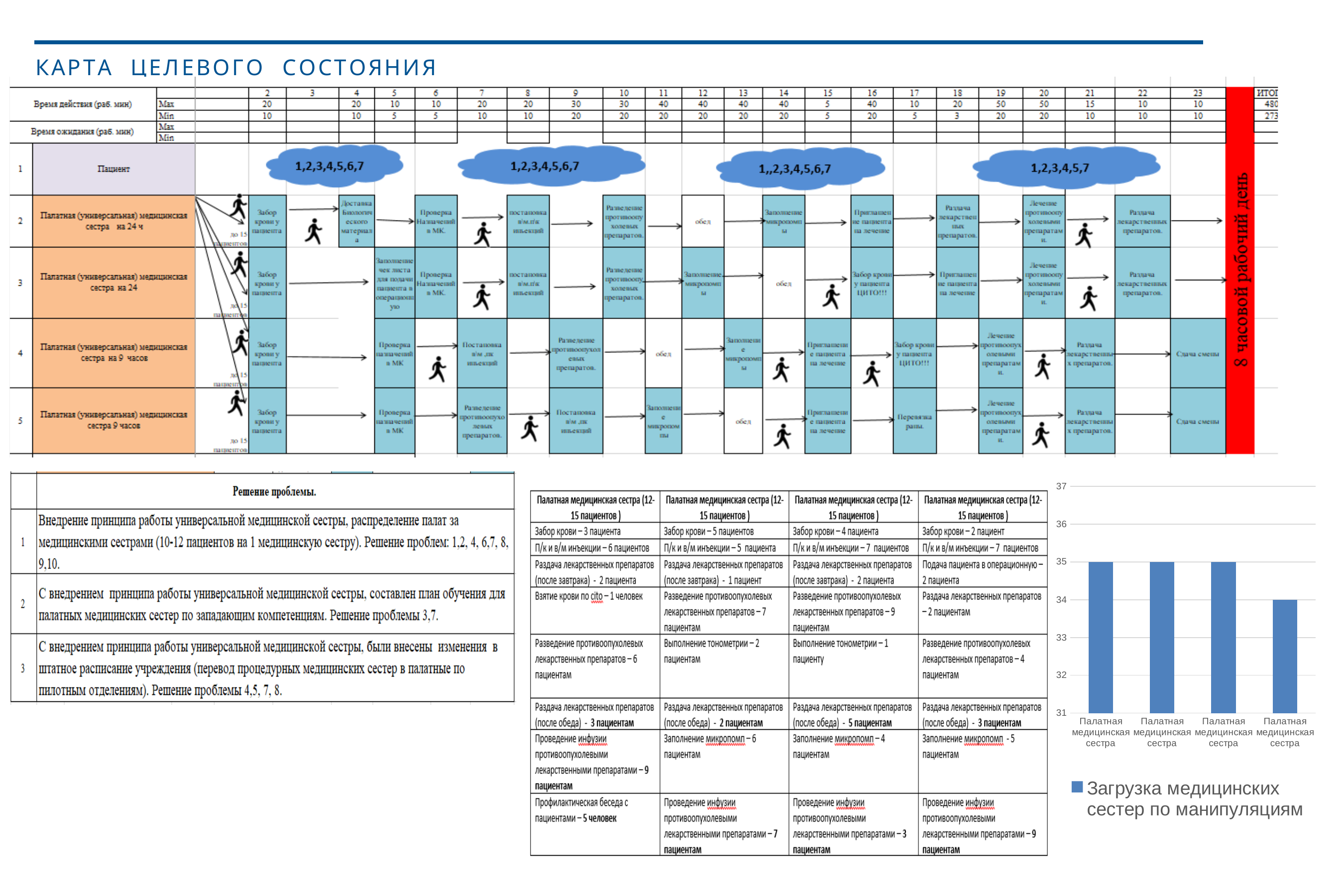
In the bar chart, which bar is the lowest? the fourth (rightmost) bar In the bar chart, which is larger: the third bar or the fourth bar? the third bar In the bar chart, what is the value of the first (leftmost) bar? 35 In the bar chart, what is the difference between the first bar and the fourth bar? 1 In the bar chart, what is the value of the fourth (rightmost) bar? 34 What is the legend entry of the bar chart on the right side of the slide? Загрузка медицинских сестер по манипуляциям In the bar chart, do the values rise or fall from the third bar to the fourth bar? fall What kind of chart is shown on the right side of the slide? bar chart What category label is shown under each bar of the bar chart? Палатная медицинская сестра How many bars does the bar chart on the right side of the slide have? 4 In the bar chart, is the value of the fourth bar greater or less than 35? less How many series does the legend of the bar chart list? 1